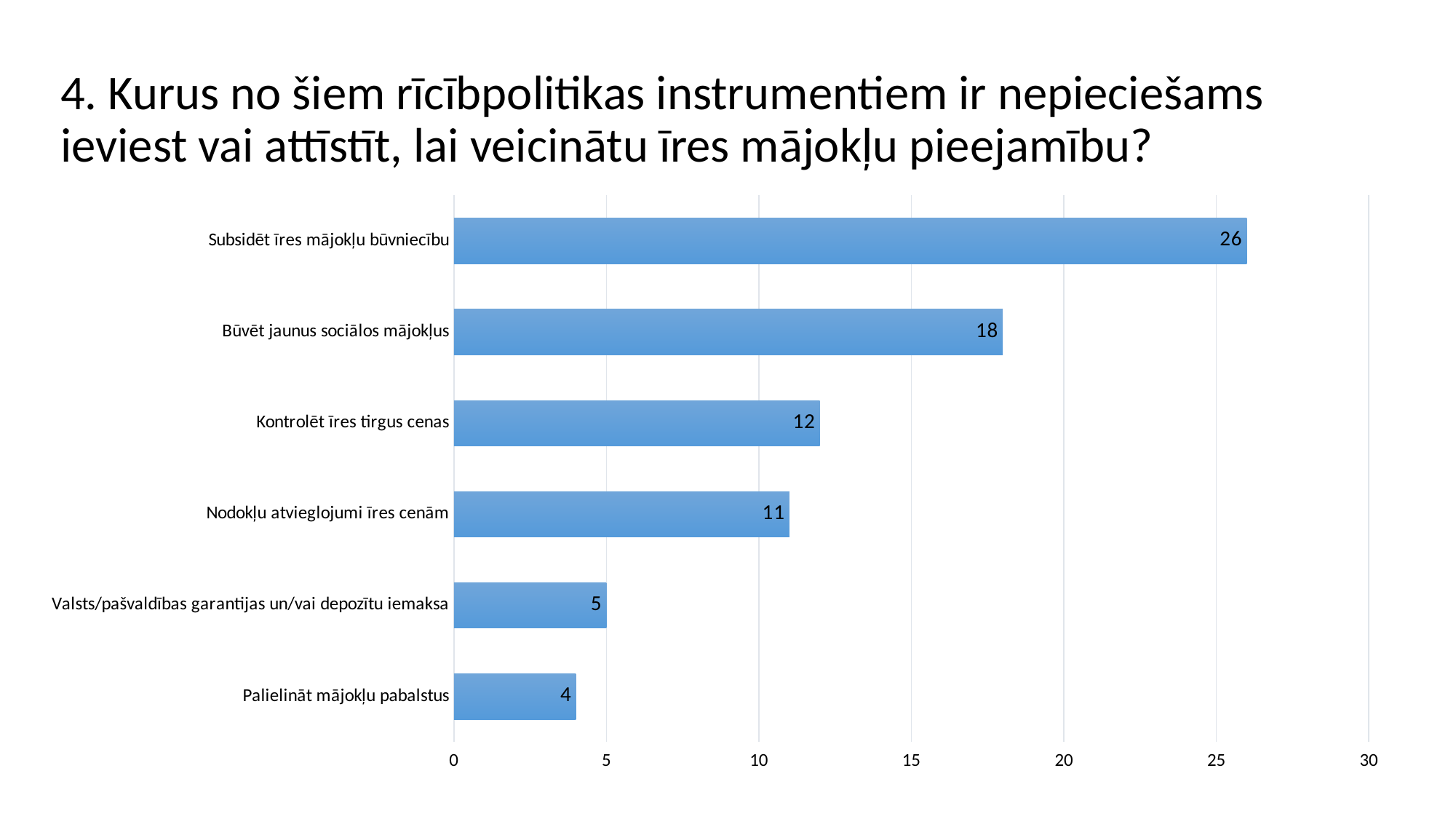
What is the highest value shown on the horizontal axis? 30 What is the difference between the values for "Subsidēt īres mājokļu būvniecību" and "Būvēt jaunus sociālos mājokļus"? 8 What is the difference between the values for "Valsts/pašvaldības garantijas un/vai depozītu iemaksa" and "Palielināt mājokļu pabalstus"? 1 Which is larger: the value for "Kontrolēt īres tirgus cenas" or the value for "Nodokļu atvieglojumi īres cenām"? Kontrolēt īres tirgus cenas Is the value for "Būvēt jaunus sociālos mājokļus" greater or less than 15? greater What is the value for "Valsts/pašvaldības garantijas un/vai depozītu iemaksa"? 5 What kind of chart is shown on the slide? bar chart Which category has the lowest value? Palielināt mājokļu pabalstus How many categories are shown in the chart? 6 What is the value for "Kontrolēt īres tirgus cenas"? 12 What is the value for "Subsidēt īres mājokļu būvniecību"? 26 Which category has the highest value? Subsidēt īres mājokļu būvniecību